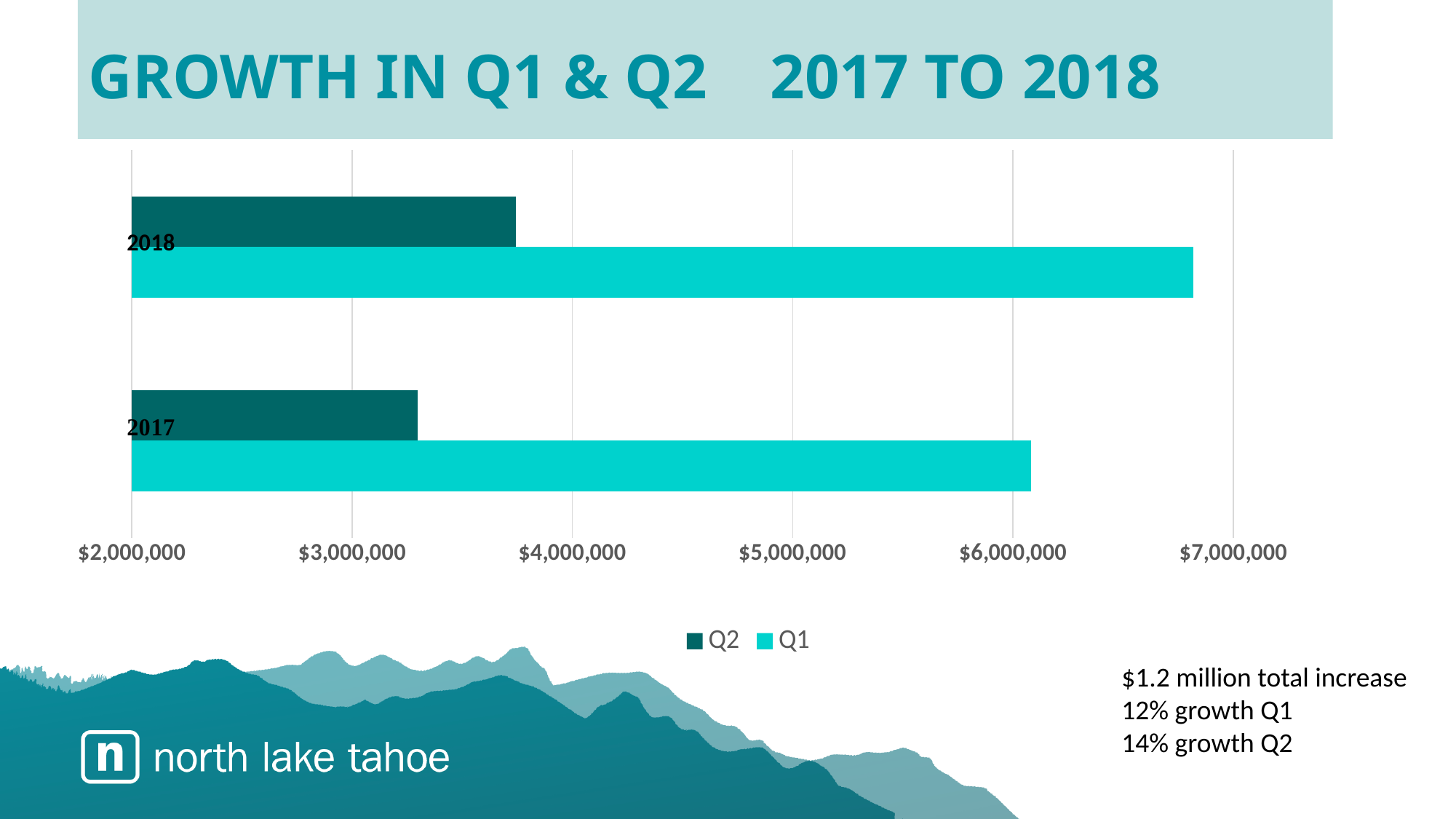
Which bar is the shortest on the chart? Q2 in 2017 Which bar is the longest on the chart? Q1 in 2018 Which year has the larger Q2 value, 2017 or 2018? 2018 Is the Q2 value for 2018 greater or less than $4,000,000? less Is the Q1 value for 2018 greater or less than $6,000,000? greater Which year has the larger Q1 value, 2017 or 2018? 2018 How many years (categories) are plotted on the chart? 2 Is the Q2 value for 2017 greater or less than $3,000,000? greater How many series does the legend list? 2 What is the title of the slide containing the chart? GROWTH IN Q1 & Q2 2017 TO 2018 What kind of chart is shown on the slide? bar chart